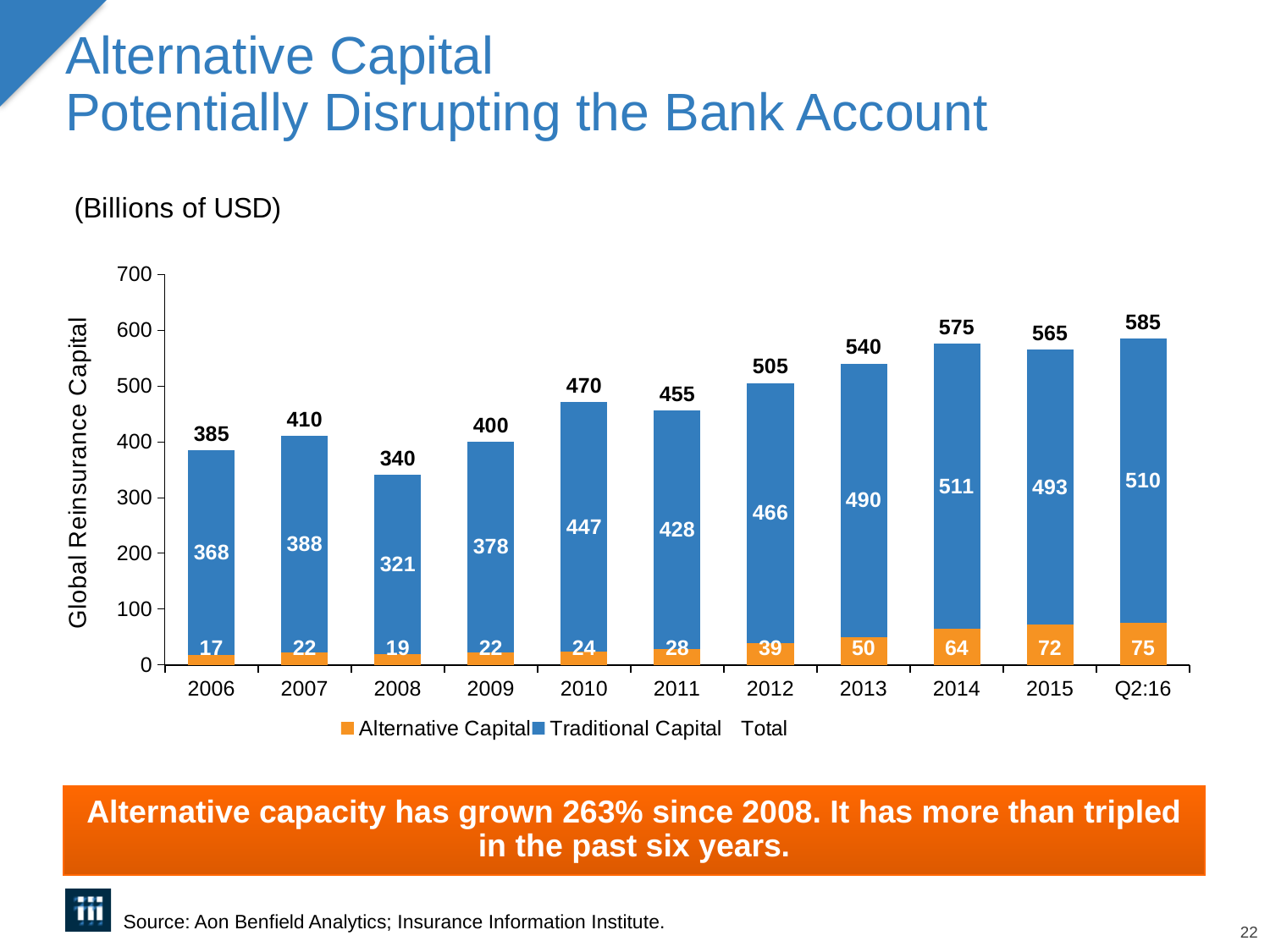
How many entries does the legend list? 3 Which year has the highest Total value? Q2:16 Which is larger, the Traditional Capital value for 2013 or for 2015? 2015 What is the Total value shown for 2008? 340 Which year has the lowest Alternative Capital value? 2006 What kind of chart is shown on the slide? Stacked bar chart What is the Alternative Capital value for 2012? 39 What is the difference between the Alternative Capital values for Q2:16 and 2008? 56 How many time periods are shown on the x axis? 11 What is the Traditional Capital value for 2014? 511 What is the total of the stacked bar for 2013? 540 Is the Total value for 2010 greater or less than 400? greater